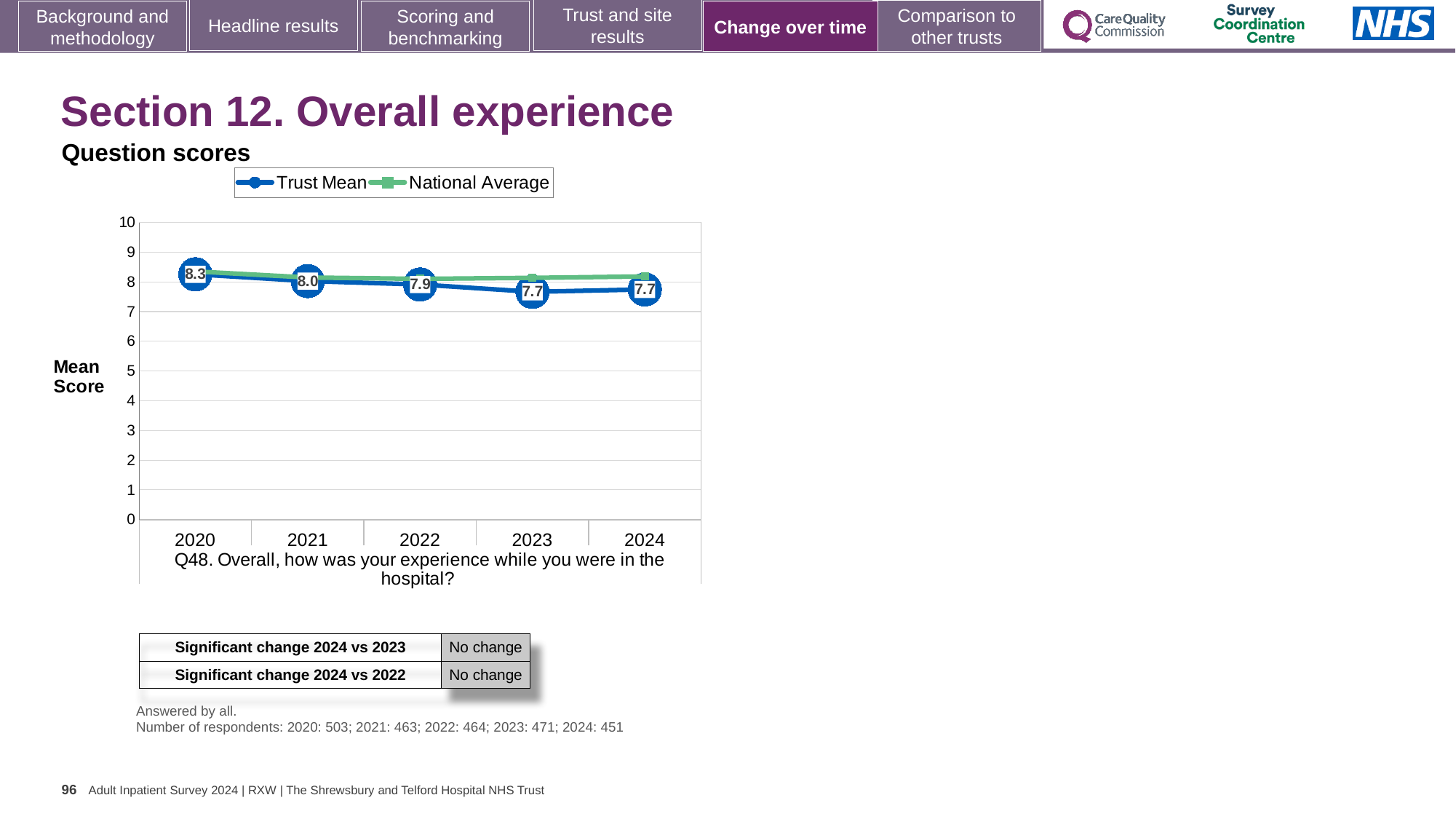
What is the label on the y axis of the chart? Mean Score Is the National Average value for 2024 greater or less than 7? greater Does the Trust Mean score generally rise or fall from 2020 to 2024? Fall What kind of chart is shown? Line chart What is the Trust Mean score for 2023? 7.7 What is the Trust Mean score for 2021? 8.0 What is the Trust Mean score for 2020? 8.3 What is the difference between the Trust Mean score in 2020 and in 2024? 0.6 Which is larger, the Trust Mean score for 2021 or for 2023? 2021 How many series does the legend list? 2 In which year is the Trust Mean score highest? 2020 How many years are plotted on the x axis? 5